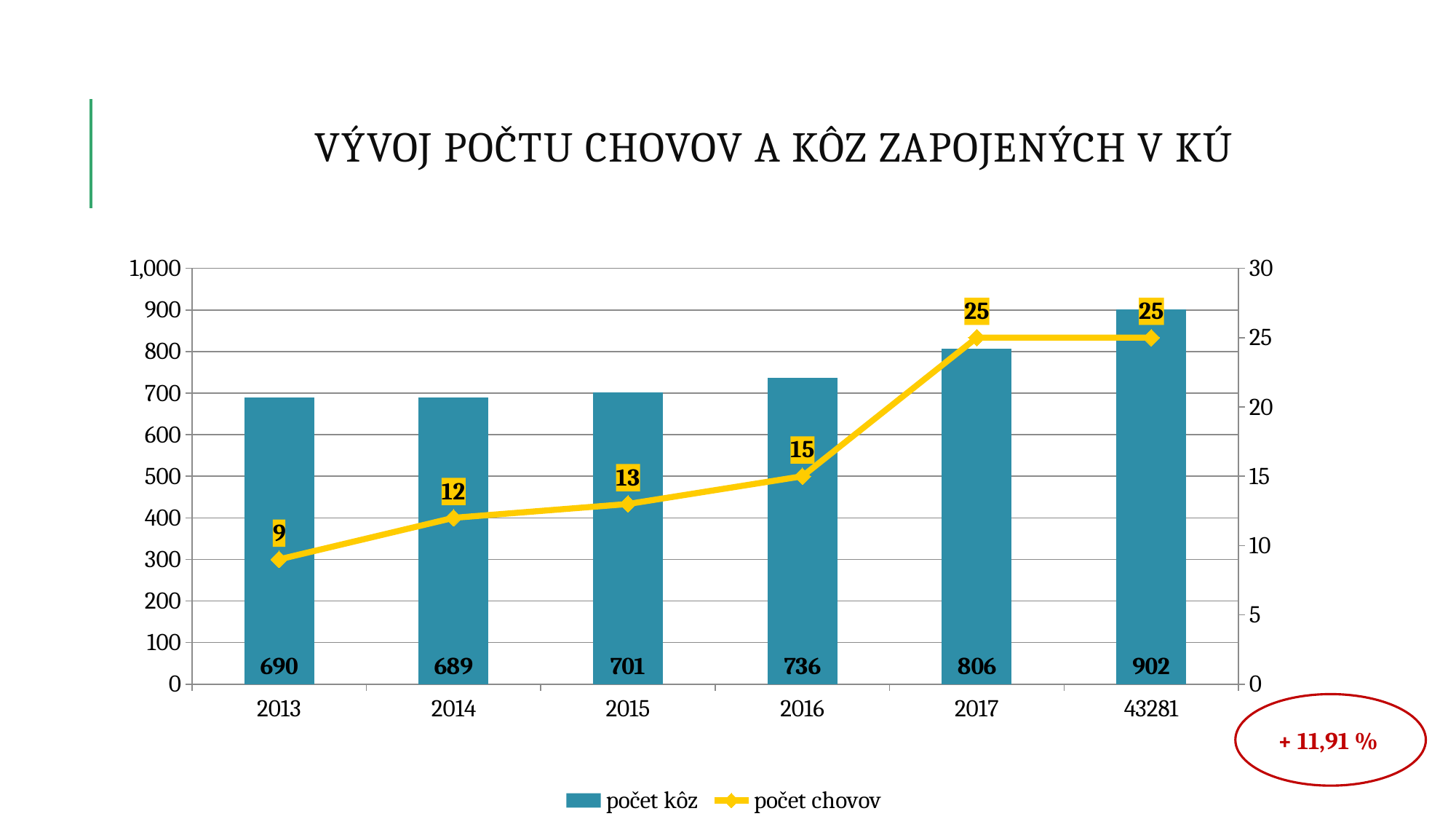
Which category has the highest value of počet kôz? 43281 Which is larger, počet kôz for 2013 or for 2014? 2013 How many series does the legend list? 2 What is the title of the chart? VÝVOJ POČTU CHOVOV A KÔZ ZAPOJENÝCH V KÚ What kind of chart is this? Combined bar and line chart How many categories are shown on the x axis? 6 What is the difference in počet kôz between 2017 and 2016? 70 Does počet chovov rise or fall from 2013 to 2017? Rise What is the value of počet kôz for the category labelled 43281? 902 What is the value of počet kôz for 2016? 736 What is the value of počet chovov for 2015? 13 Which category has the lowest value of počet chovov? 2013